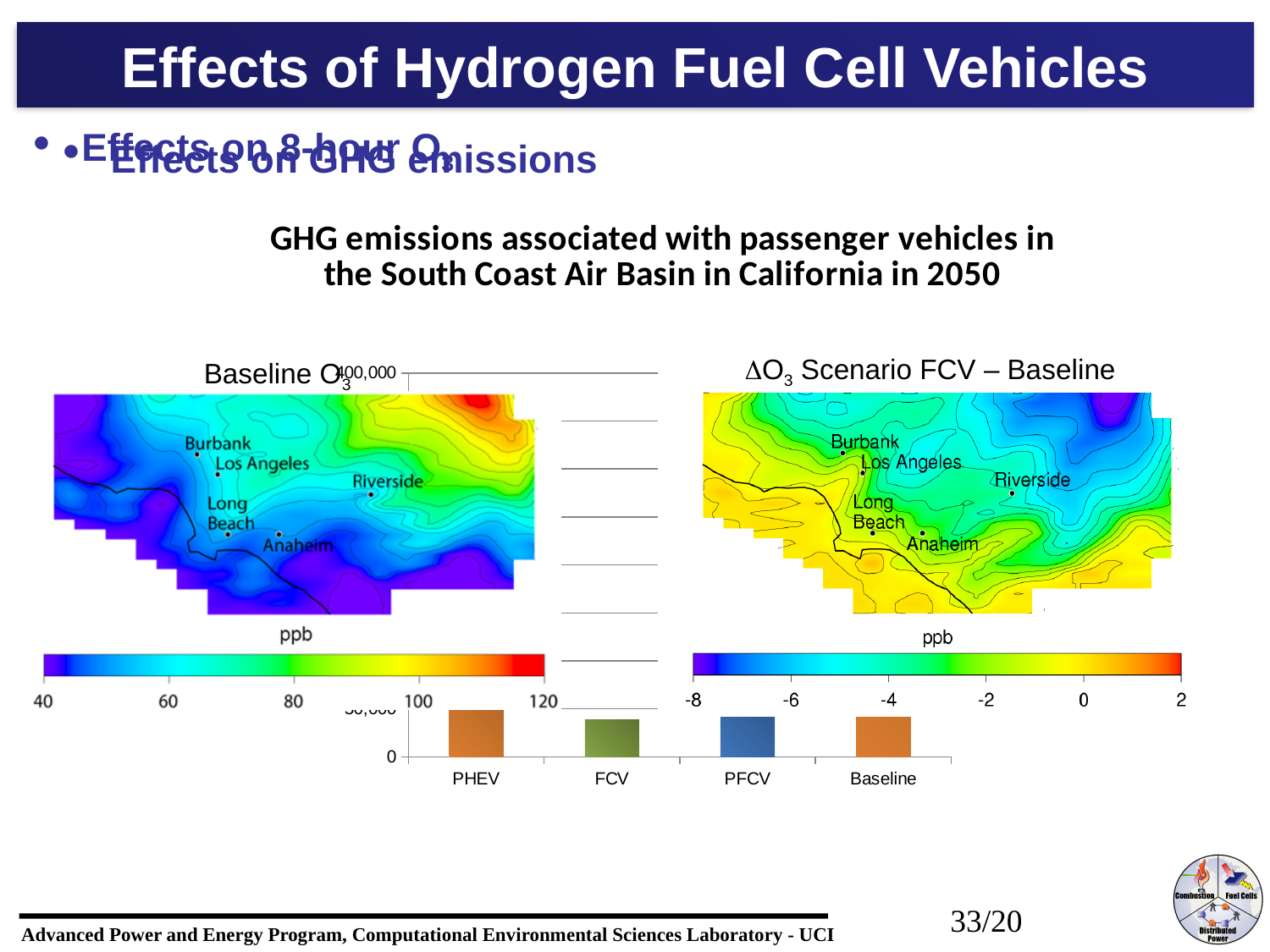
What is the highest value shown on the y axis of the GHG emissions bar chart? 400,000 What are the category labels on the x axis of the GHG emissions bar chart? PHEV, FCV, PFCV, Baseline In the GHG emissions bar chart, is the value for Baseline greater or less than 400,000? less What kind of chart is the chart titled 'GHG emissions associated with passenger vehicles in the South Coast Air Basin in California in 2050'? bar chart In the GHG emissions bar chart, is the value for FCV greater or less than 400,000? less How many categories are shown on the x axis of the GHG emissions bar chart? 4 In the GHG emissions bar chart, is the bar for PHEV taller or shorter than the bar for FCV? taller In the GHG emissions bar chart, is the value for PHEV greater or less than 400,000? less